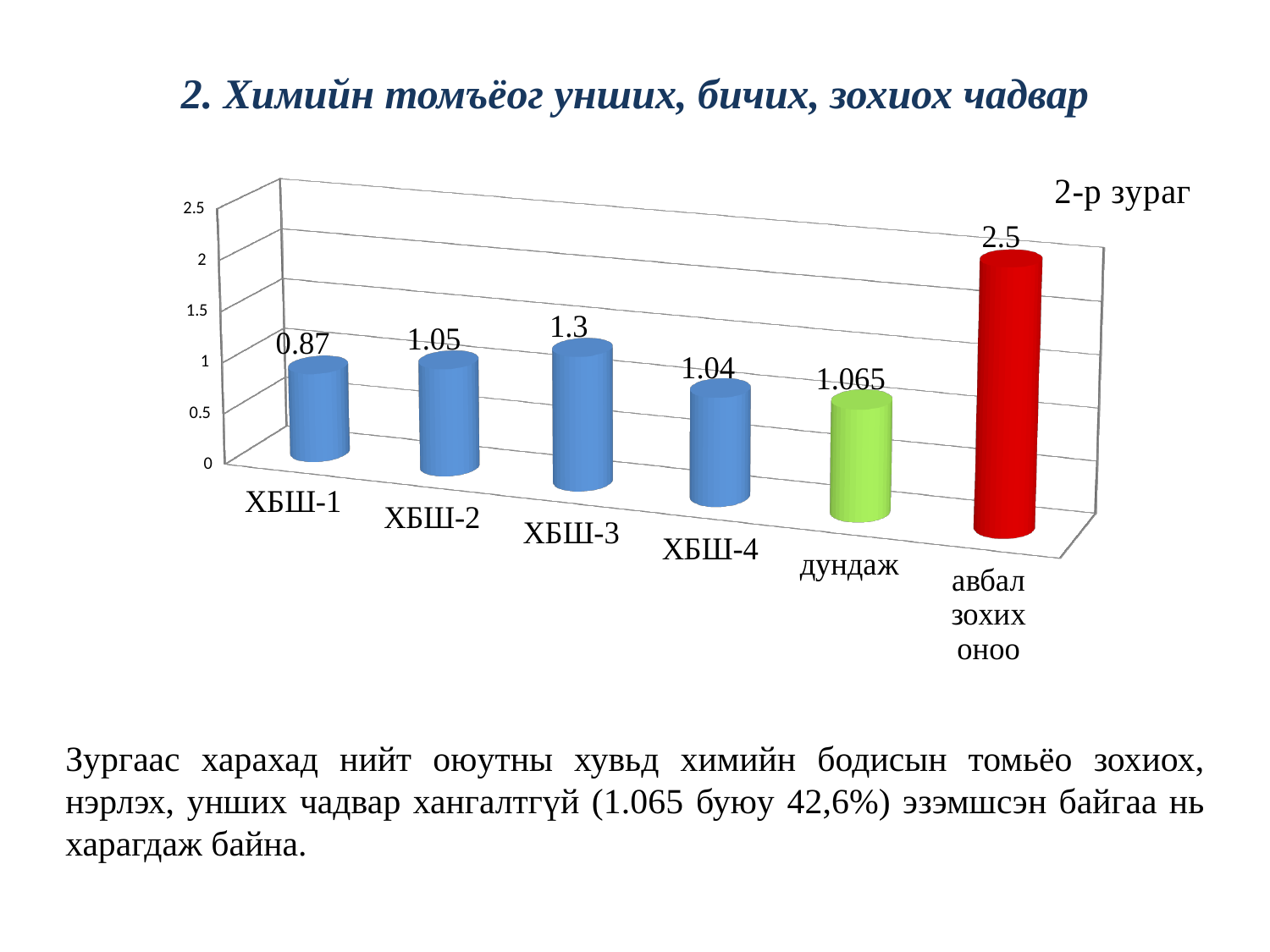
Which category has the lowest value? ХБШ-1 What is the value for авбал зохих оноо? 2.5 Which is larger, the value for ХБШ-3 or the value for ХБШ-4? ХБШ-3 What is the difference between the values for ХБШ-2 and ХБШ-1? 0.18 How many categories are shown on the chart? 6 What is the value for ХБШ-3? 1.3 What is the value for ХБШ-1? 0.87 What is the title of the slide above the chart? 2. Химийн томъёог унших, бичих, зохиох чадвар What kind of chart is shown on the slide? bar chart What is the difference between the values for авбал зохих оноо and ХБШ-3? 1.2 Which category has the highest value? авбал зохих оноо What is the value for дундаж? 1.065